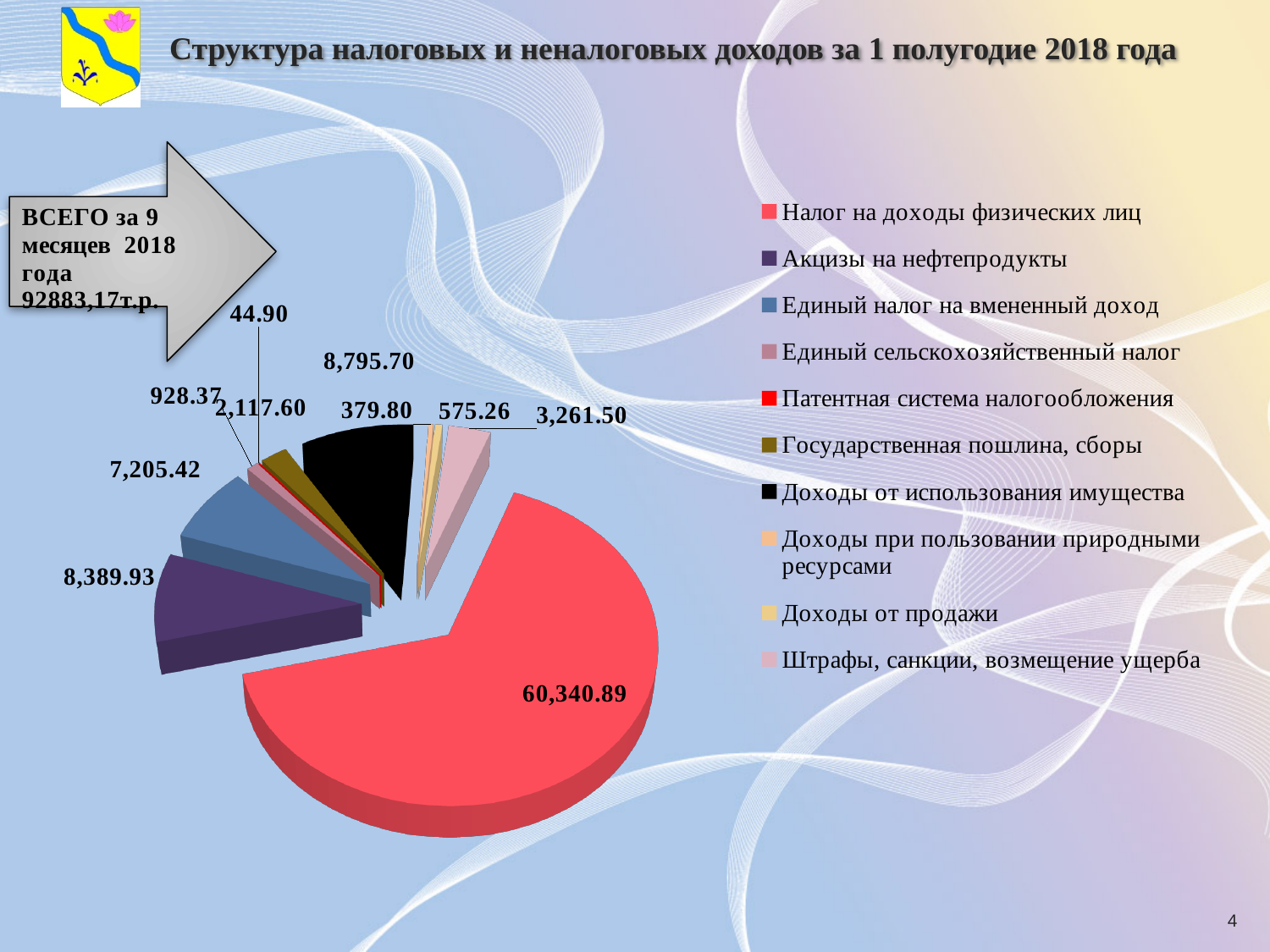
What is the value of the smallest slice of the pie chart? 44.90 How many categories does the legend of the pie chart list? 10 What is the value shown for Доходы от использования имущества? 8,795.70 What kind of chart is shown on the slide? Pie chart Which category has the smallest slice of the pie chart? Патентная система налогообложения What is the value shown for Штрафы, санкции, возмещение ущерба? 3,261.50 What is the value shown for Акцизы на нефтепродукты? 8,389.93 What is the value of the largest slice of the pie chart? 60,340.89 Which category has the largest slice of the pie chart? Налог на доходы физических лиц Which is larger: Акцизы на нефтепродукты or Единый налог на вмененный доход? Акцизы на нефтепродукты What is the title of the slide containing the pie chart? Структура налоговых и неналоговых доходов за 1 полугодие 2018 года What is the difference between Доходы от использования имущества (8,795.70) and Акцизы на нефтепродукты (8,389.93)? 405.77